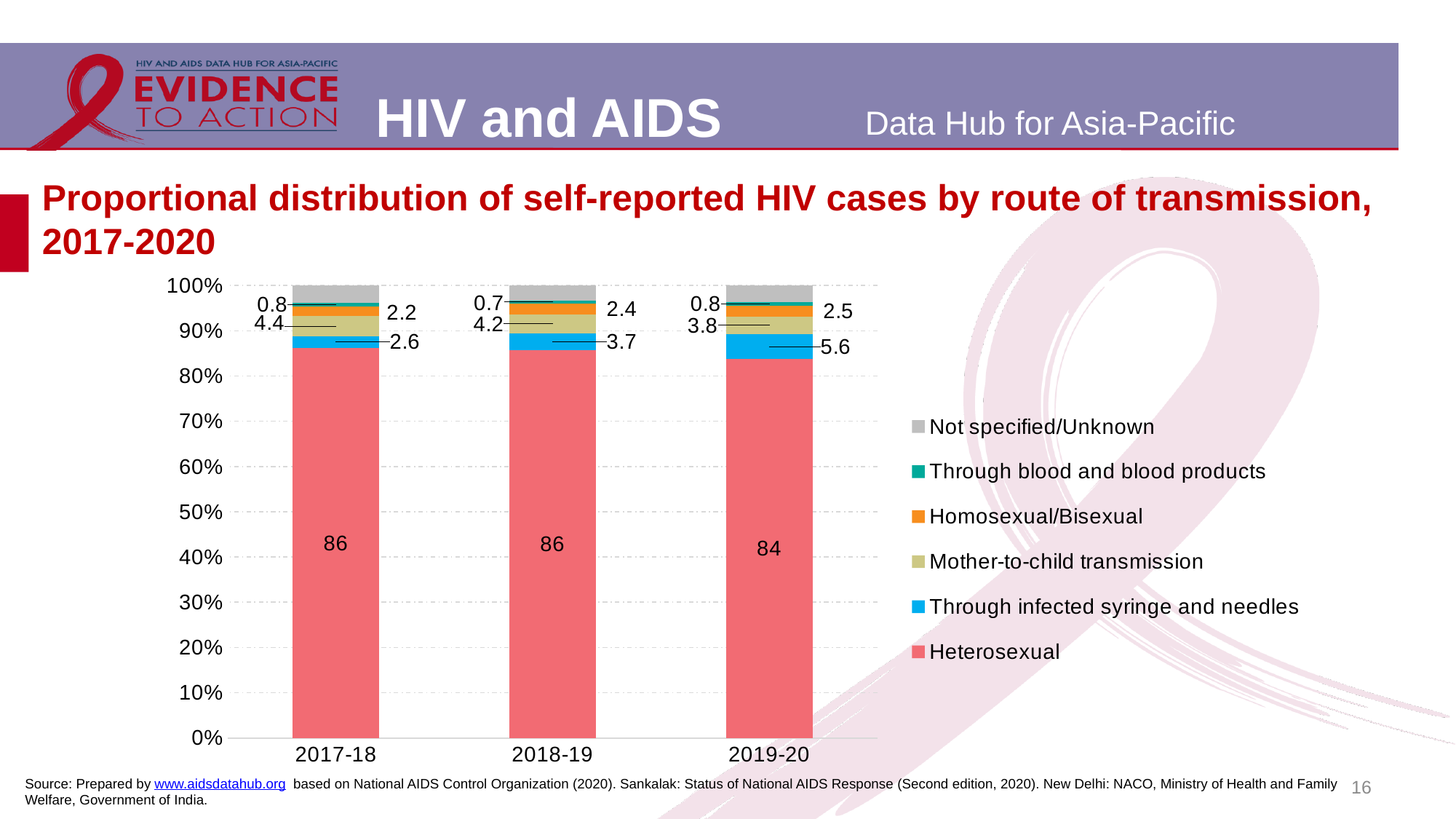
What is the value for Through blood and blood products in 2018-19? 0.7 What kind of chart is shown on the slide? Stacked bar chart What is the Heterosexual value for 2019-20? 84 What is the Mother-to-child transmission value for 2017-18? 4.4 How many series does the legend list? 6 Which is larger, the Homosexual/Bisexual value for 2018-19 or the Mother-to-child transmission value for 2018-19? Mother-to-child transmission What is the value for Through infected syringe and needles in 2018-19? 3.7 What is the difference between the Through infected syringe and needles values for 2019-20 and 2017-18? 3 How many year categories are shown on the x axis? 3 In which year is the Mother-to-child transmission value lowest? 2019-20 In which year is the Through infected syringe and needles value highest? 2019-20 What is the Homosexual/Bisexual value for 2019-20? 2.5